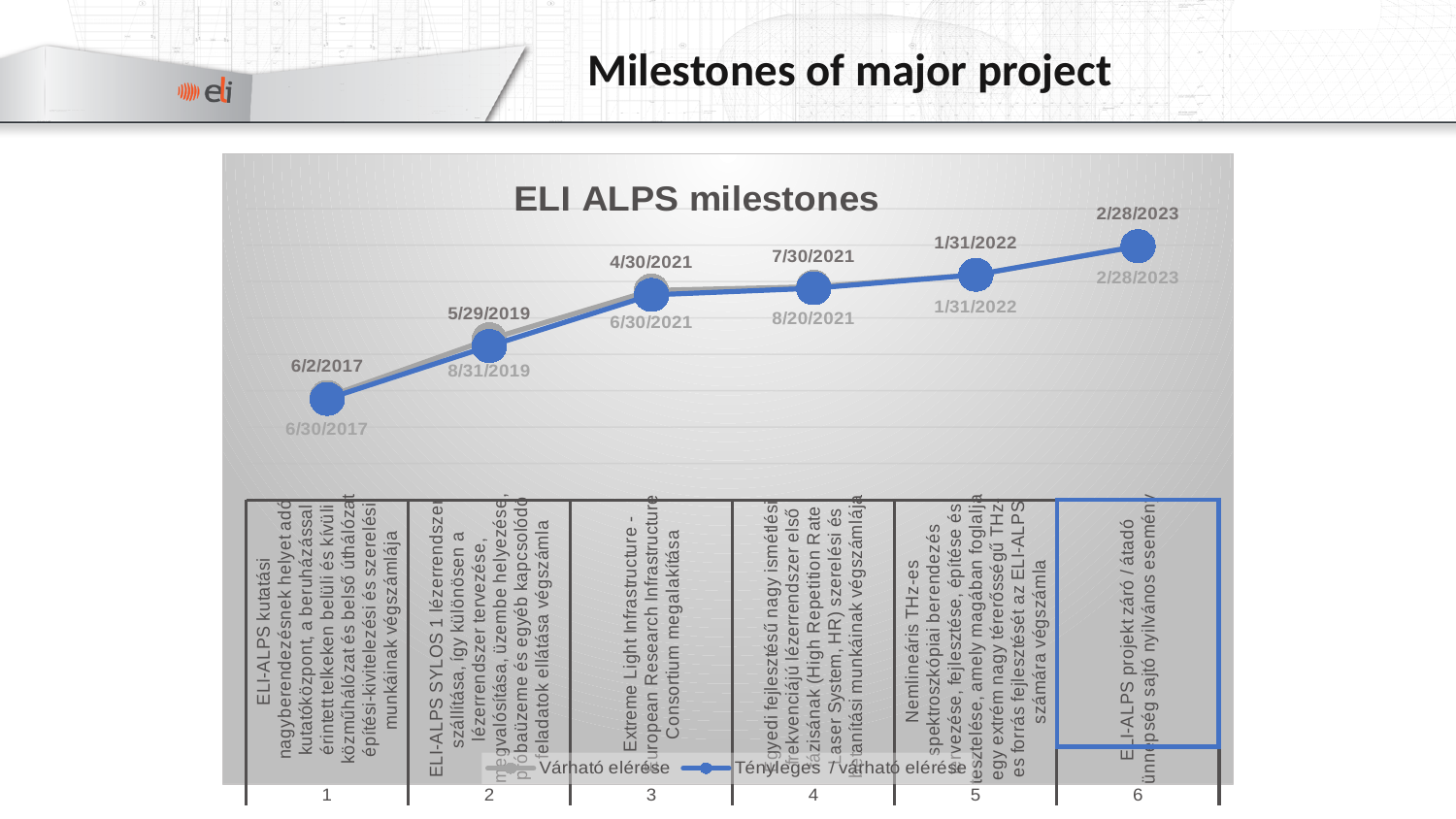
What type of chart is shown on the slide? line chart What date label is printed above the point for milestone 6? 2/28/2023 How many series does the chart legend list? 2 How many milestone points are plotted along the x axis of the chart? 6 What date label is printed above the point for milestone 2? 5/29/2019 What date label is printed above the point for milestone 1? 6/2/2017 Do the plotted dates rise or fall from milestone 1 to milestone 6? rise What date label is printed above the point for milestone 4? 7/30/2021 What date label is printed below the point for milestone 1? 6/30/2017 What date label is printed below the point for milestone 3? 6/30/2021 What is the title of the chart on the slide? ELI ALPS milestones Which legend entry is drawn with the blue line? Tényleges / várható elérése